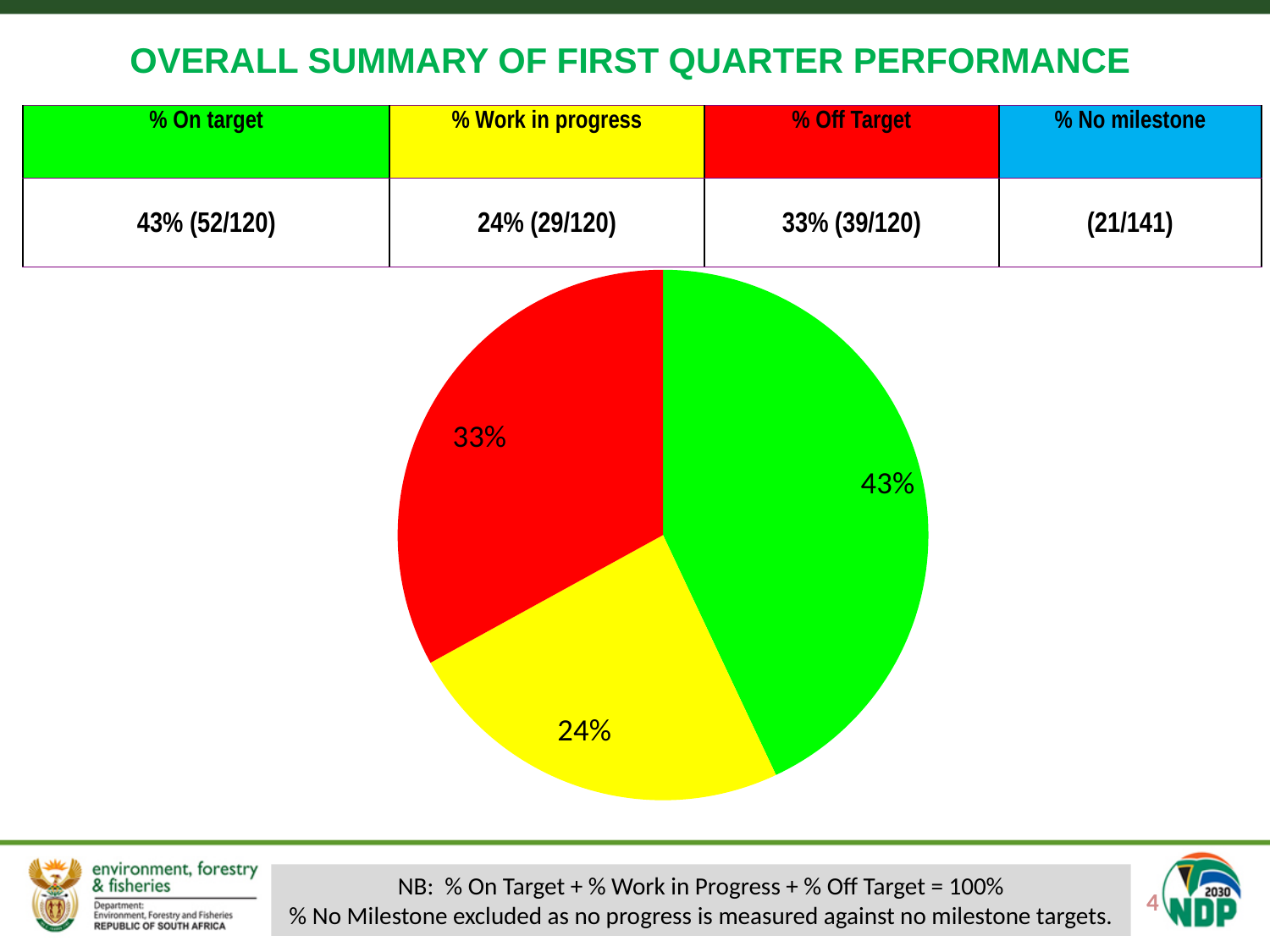
What colour is used for the On target category in the pie chart? green What share of the pie does the Off Target (red) slice represent? 33% What kind of chart is shown on the slide? pie chart What is the difference between the green slice and the red slice of the pie chart? 10% Which slice of the pie chart is the largest? 43% (green, On target) Which slice of the pie chart is the smallest? 24% (yellow, Work in progress) Which is larger in the pie chart, the red slice or the yellow slice? the red slice (33%) What percentage is shown on the yellow slice of the pie chart? 24% What percentage is shown on the green slice of the pie chart? 43% What is the difference between the green slice and the yellow slice of the pie chart? 19% How many slices does the pie chart have? 3 What percentage is shown on the red slice of the pie chart? 33%